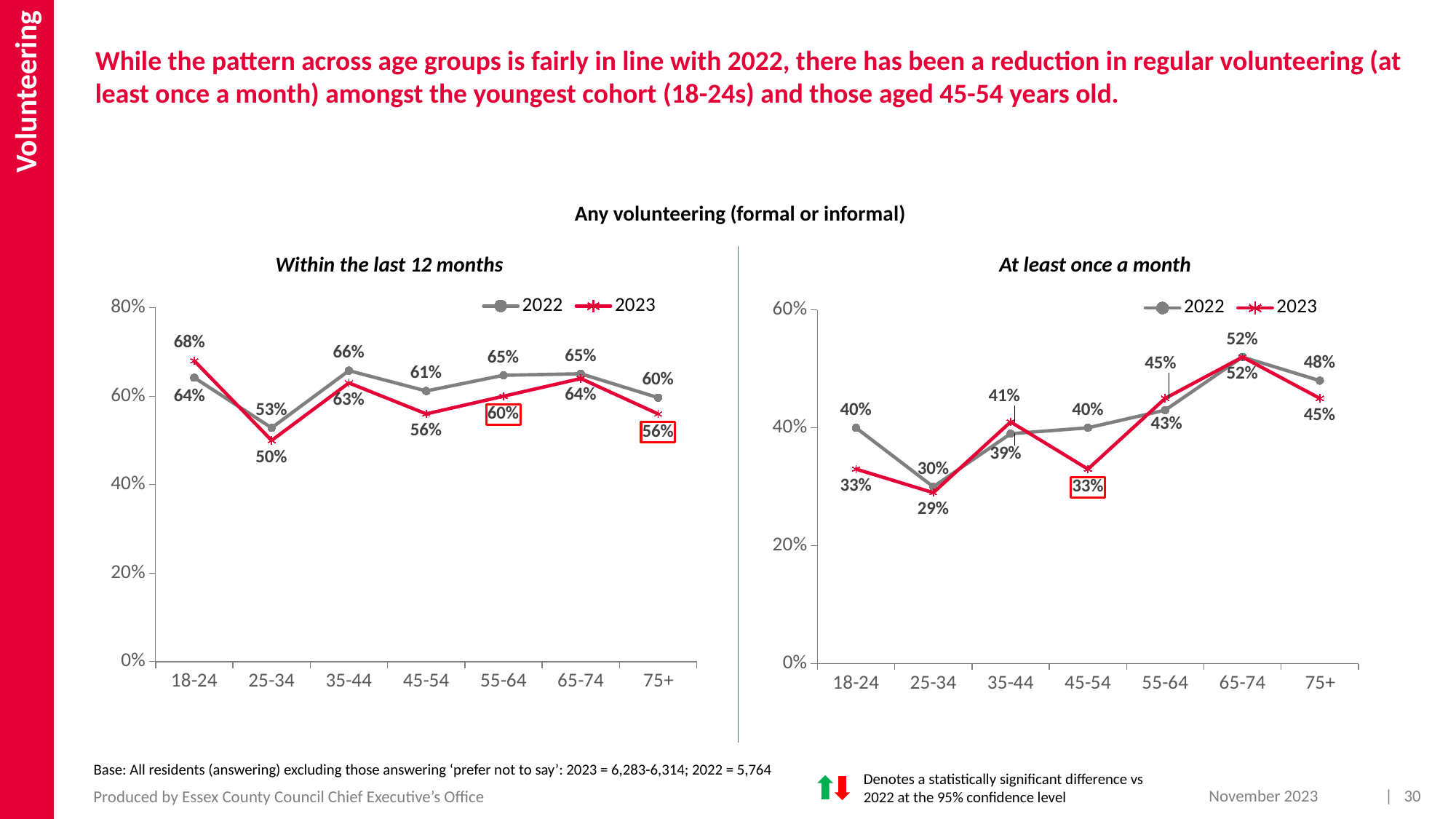
In the 'Within the last 12 months' chart, what is the difference between the 2022 and 2023 values for the 55-64 age group? 5 percentage points In the 'At least once a month' chart, which age group has the highest 2022 value? 65-74 In the 'At least once a month' chart, what is the 2023 value for the 45-54 age group? 33% What type of chart is the 'Within the last 12 months' chart? Line chart In the 'Within the last 12 months' chart, what is the 2023 value for the 18-24 age group? 68% In the 'At least once a month' chart, what is the difference between the 2022 and 2023 values for the 18-24 age group? 7 percentage points In the 'Within the last 12 months' chart, how many series does the legend list? 2 How many age groups are shown on the x axis of the 'At least once a month' chart? 7 In the 'Within the last 12 months' chart, what is the 2022 value for the 45-54 age group? 61% In the 'Within the last 12 months' chart, which age group has the lowest 2023 value? 25-34 In the 'At least once a month' chart, what is the 2022 value for the 75+ age group? 48% In the 'At least once a month' chart, which is larger for the 35-44 age group: the 2022 value or the 2023 value? 2023